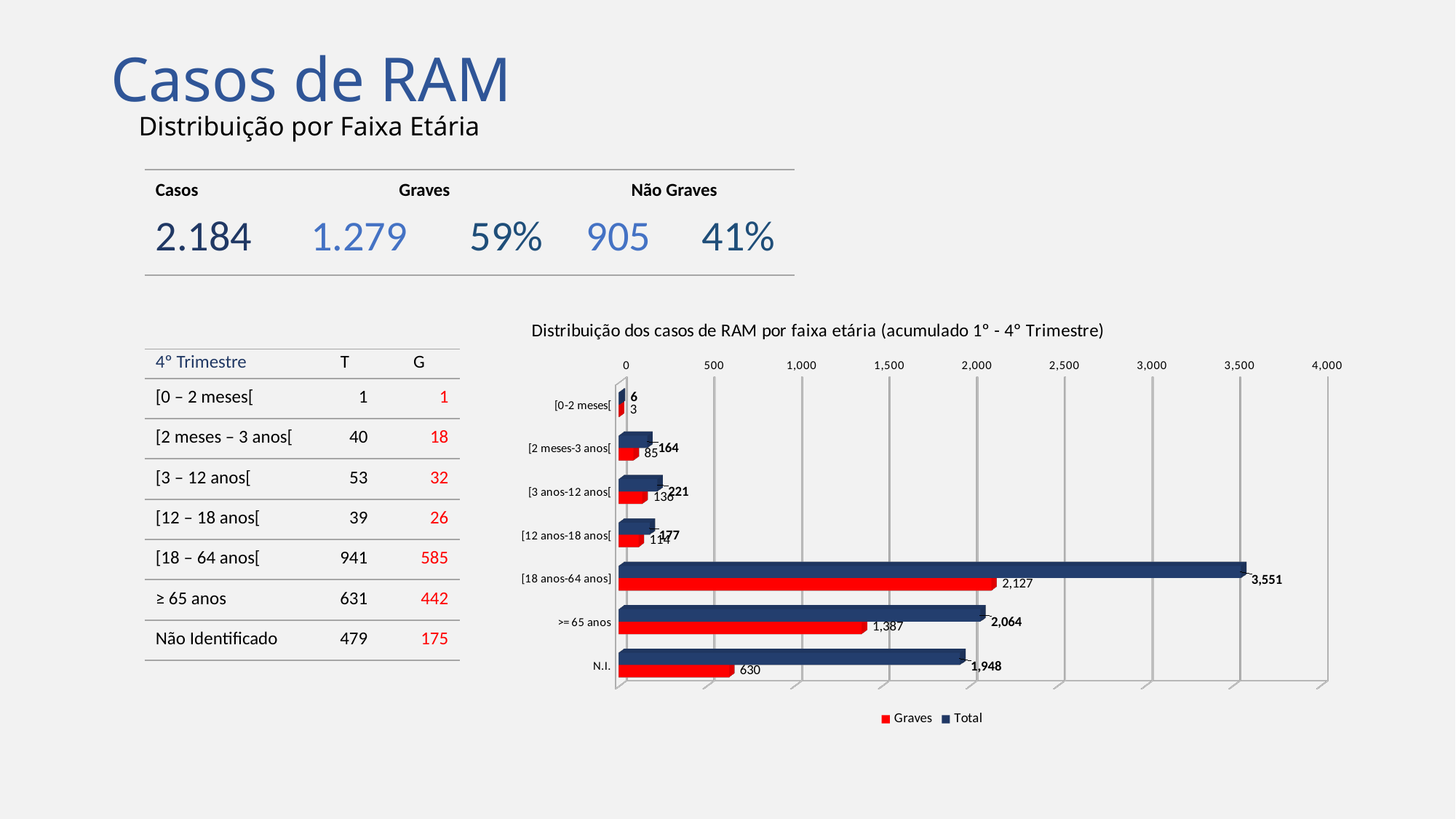
What is the difference between the Total and Graves values for the N.I. category? 1,318 What is the Graves value for the >= 65 anos age group in the chart? 1,387 Which is larger: the Graves value for [18 anos-64 anos] or the Total value for >= 65 anos? Graves value for [18 anos-64 anos] What is the Total value for the [3 anos-12 anos[ age group in the chart? 221 What is the Total value for the [18 anos-64 anos] age group in the chart? 3,551 How many series does the chart legend list? 2 What is the Graves value for the N.I. category in the chart? 630 What is the title of the chart on the slide? Distribuição dos casos de RAM por faixa etária (acumulado 1° - 4° Trimestre) What type of chart is used to show the distribution of RAM cases by age group? Bar chart Which age group has the lowest Graves value in the chart? [0-2 meses[ How many age-group categories are shown in the chart? 7 Which age group has the highest Total value in the chart? [18 anos-64 anos]